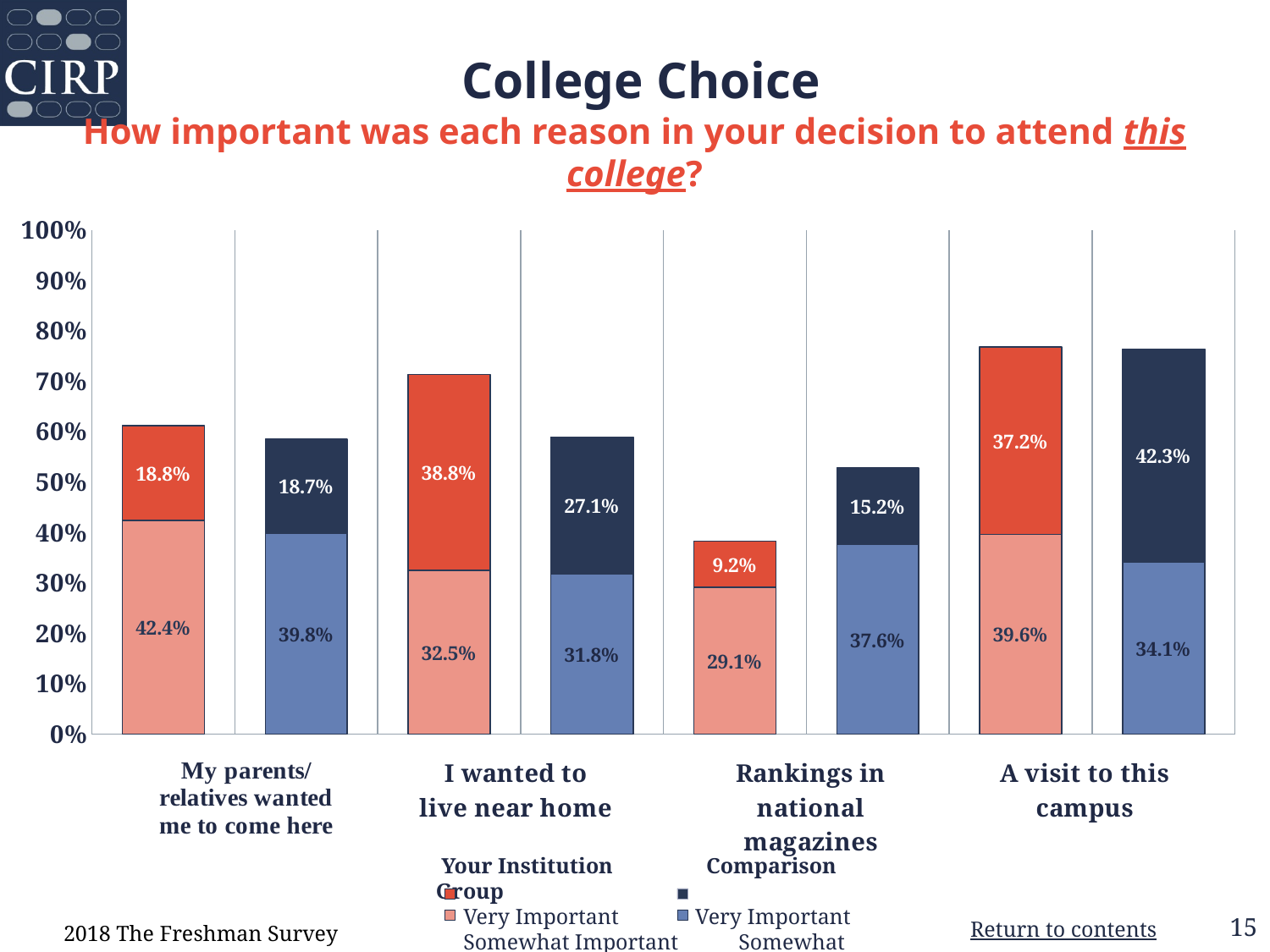
What percentage of students at Your Institution rated "I wanted to live near home" as Very Important? 38.8% What is the combined Very Important and Somewhat Important percentage for Your Institution for "I wanted to live near home"? 71.3% Which reason has the highest Very Important percentage for the Comparison Group? A visit to this campus What percentage of students at Your Institution rated "A visit to this campus" as Very Important? 37.2% What is the combined Very Important and Somewhat Important percentage for the Comparison Group for "Rankings in national magazines"? 52.8% How many reasons (categories) are shown on the x axis of the chart? 4 For "Rankings in national magazines", which group has the larger Very Important percentage, Your Institution or the Comparison Group? Comparison Group What is the difference between the Very Important percentages for Your Institution and the Comparison Group for "I wanted to live near home"? 11.7% Is the total stacked bar for Your Institution for "A visit to this campus" greater or less than 70%? greater What kind of chart is shown on the slide? Stacked bar chart What percentage of the Comparison Group rated "Rankings in national magazines" as Somewhat Important? 37.6% Which reason has the lowest Very Important percentage for Your Institution? Rankings in national magazines